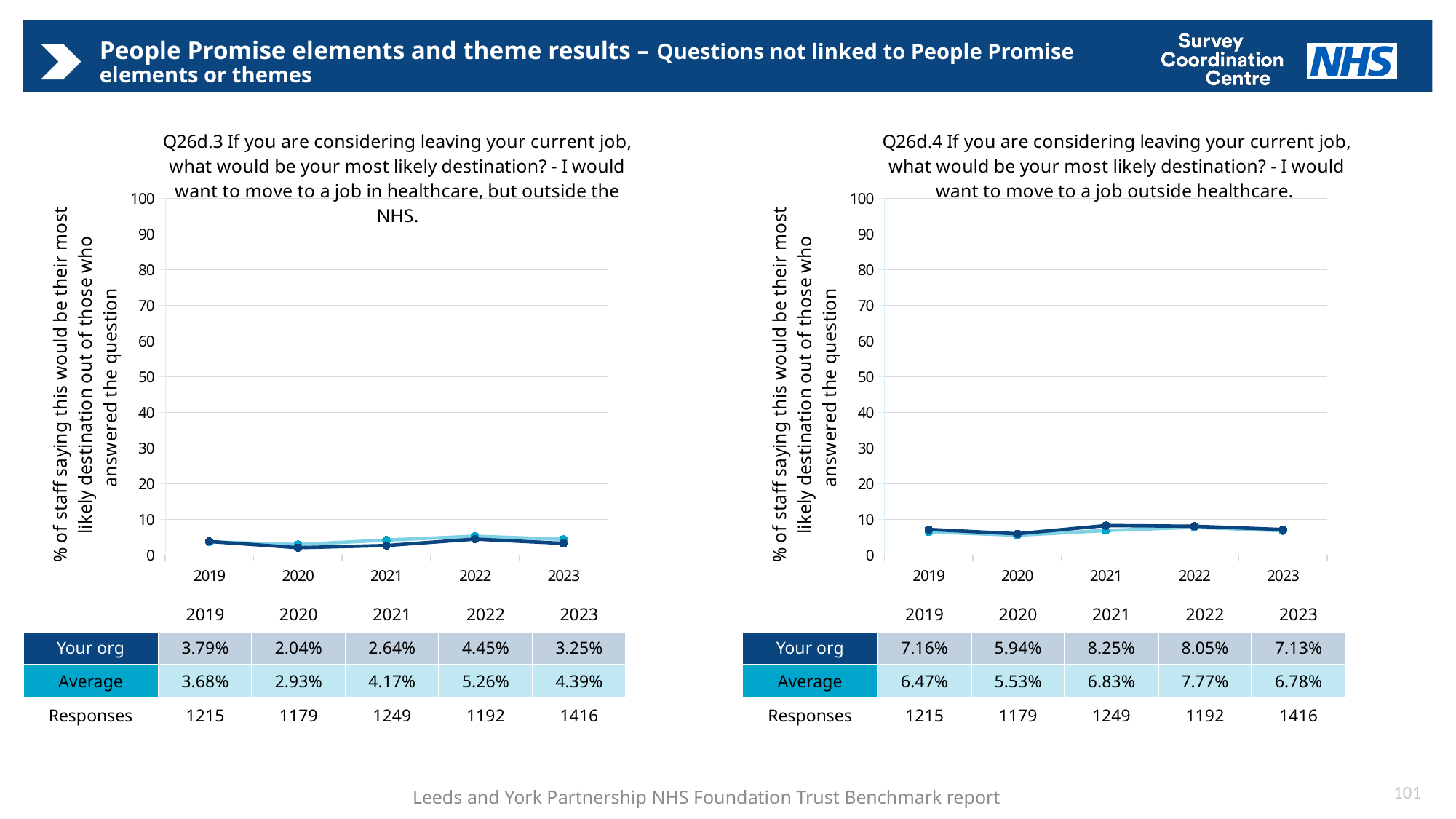
In the Q26d.4 chart (right), how many responses were recorded for 2023? 1416 How many years are plotted on the x axis of the Q26d.3 chart (left)? 5 How many series are shown in the Q26d.4 chart (right)? 2 In the Q26d.4 chart (right), what is the Average value for 2020? 5.53% In the Q26d.3 chart (left), what is the difference between the Average and Your org values in 2021? 1.53 percentage points In the Q26d.4 chart (right), is the Your org value for 2021 greater or less than 10? less In the Q26d.3 chart (left), in which year is the Average value highest? 2022 In the Q26d.4 chart (right), in which year is the Your org value lowest? 2020 What type of chart is used for Q26d.3 (left)? Line chart In the Q26d.3 chart (left), what is the Your org value for 2022? 4.45% In the Q26d.4 chart (right), which is larger in 2019: Your org or Average? Your org In the Q26d.3 chart (left), does the Your org value rise or fall from 2019 to 2020? Fall